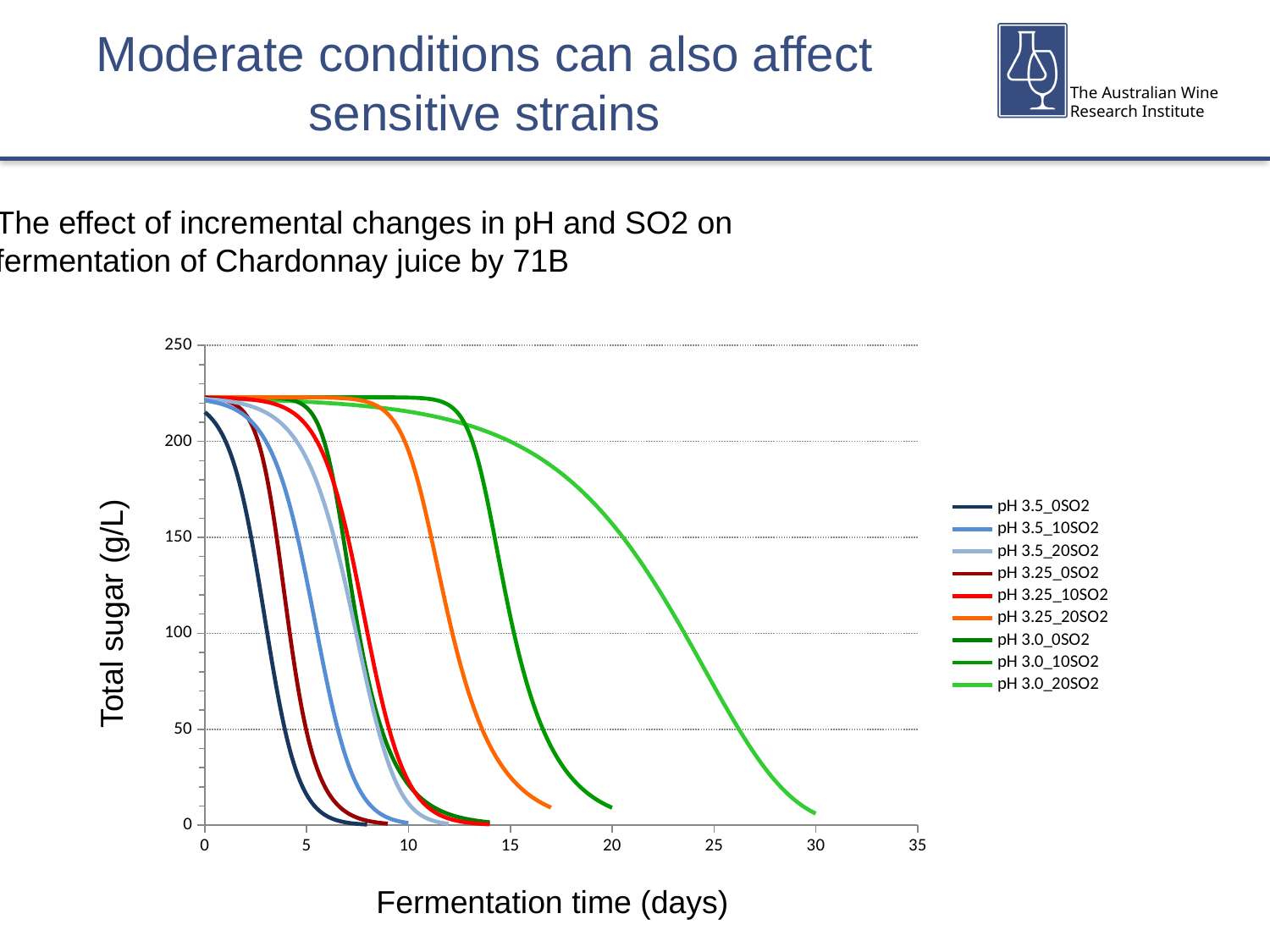
Do the total sugar values rise or fall as fermentation time increases? fall What kind of chart is shown on the slide? line chart At 20 days, which series has the higher total sugar: pH 3.0_20SO2 or pH 3.0_10SO2? pH 3.0_20SO2 Which series reaches near-zero total sugar in the shortest fermentation time? pH 3.5_0SO2 Which series takes the longest fermentation time to reach near-zero total sugar? pH 3.0_20SO2 How many series does the legend list? 9 What is the label of the x axis? Fermentation time (days) Is the value for pH 3.25_20SO2 at 10 days greater or less than 200? greater Is the value for pH 3.0_20SO2 at 10 days greater or less than 200? greater Is the value for pH 3.0_20SO2 at 25 days greater or less than 100? less What is the label of the y axis? Total sugar (g/L)